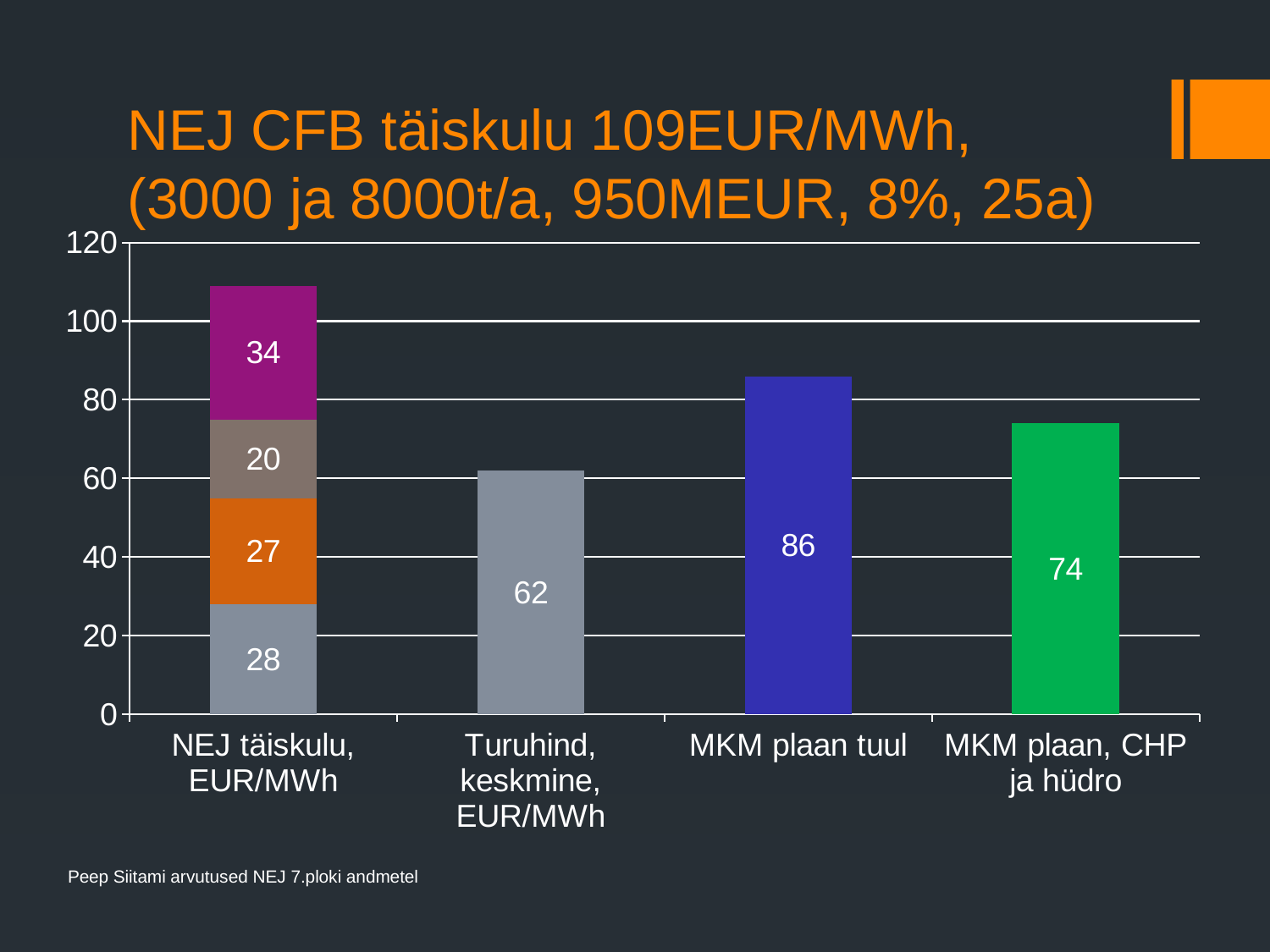
What kind of chart is shown on the slide? Bar chart How many categories are shown on the x axis? 4 What is the total of the stacked NEJ täiskulu, EUR/MWh bar? 109 Which is larger, the value for MKM plaan tuul or the value for Turuhind, keskmine, EUR/MWh? MKM plaan tuul Which category has the lowest value? Turuhind, keskmine, EUR/MWh What is the difference between the values for MKM plaan tuul and MKM plaan, CHP ja hüdro? 12 What is the value of the top (purple) segment of the NEJ täiskulu, EUR/MWh bar? 34 What is the value for MKM plaan tuul? 86 What is the value for Turuhind, keskmine, EUR/MWh? 62 What is the value of the bottom (grey) segment of the NEJ täiskulu, EUR/MWh bar? 28 What is the value for MKM plaan, CHP ja hüdro? 74 Which category has the highest total value? NEJ täiskulu, EUR/MWh